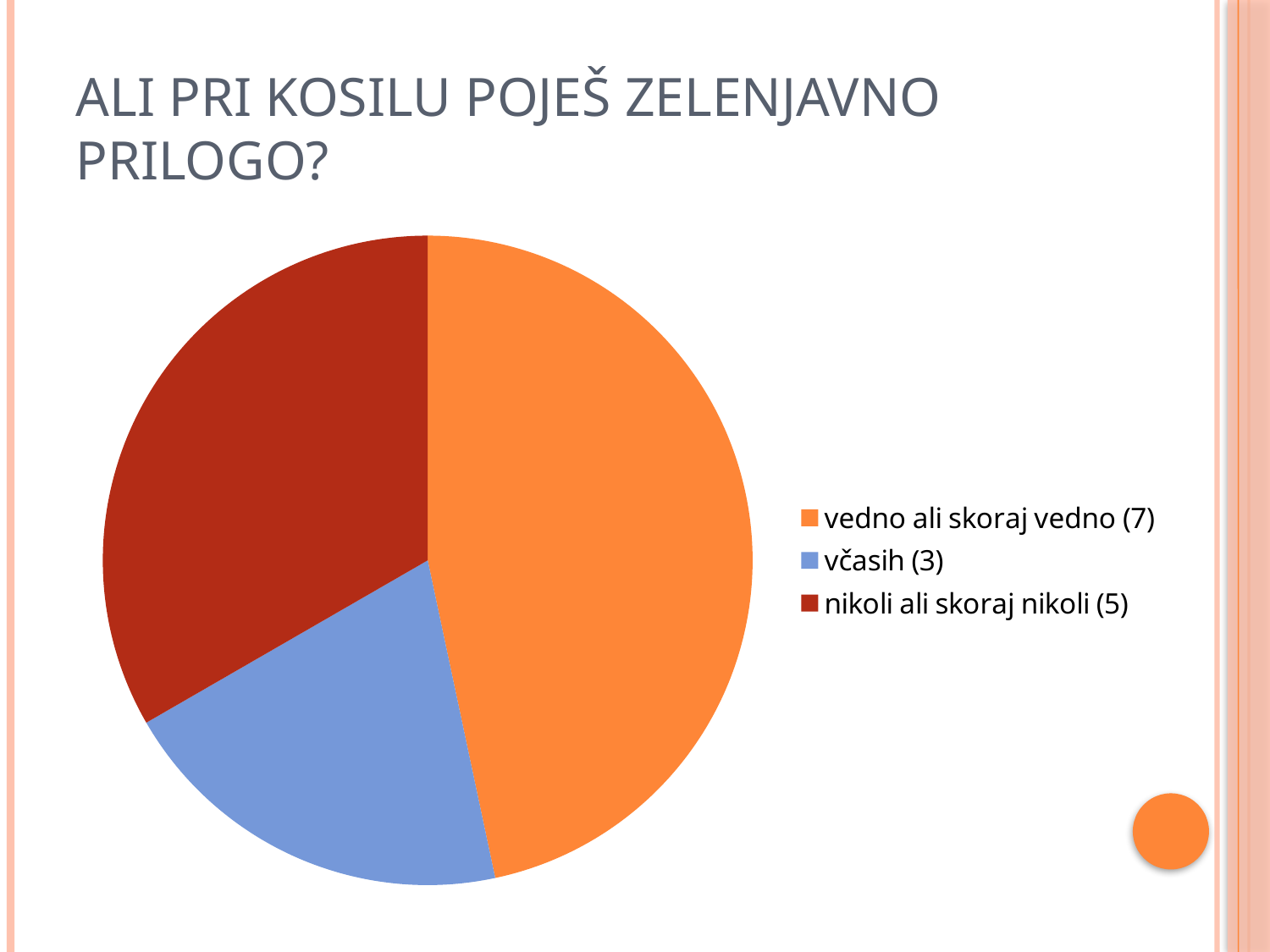
How many slices does the pie chart have? 3 What is the value for "nikoli ali skoraj nikoli"? 5 What is the difference between the values for "vedno ali skoraj vedno" and "nikoli ali skoraj nikoli"? 2 Which category has the smallest slice? včasih What colour is the slice for "nikoli ali skoraj nikoli"? dark red Which is larger, the value for "nikoli ali skoraj nikoli" or the value for "včasih"? nikoli ali skoraj nikoli What kind of chart is shown on the slide? pie chart What is the value for "vedno ali skoraj vedno"? 7 Which category has the largest slice? vedno ali skoraj vedno What is the value for "včasih"? 3 How many entries does the legend list? 3 What share of the pie does "včasih" represent? 20%